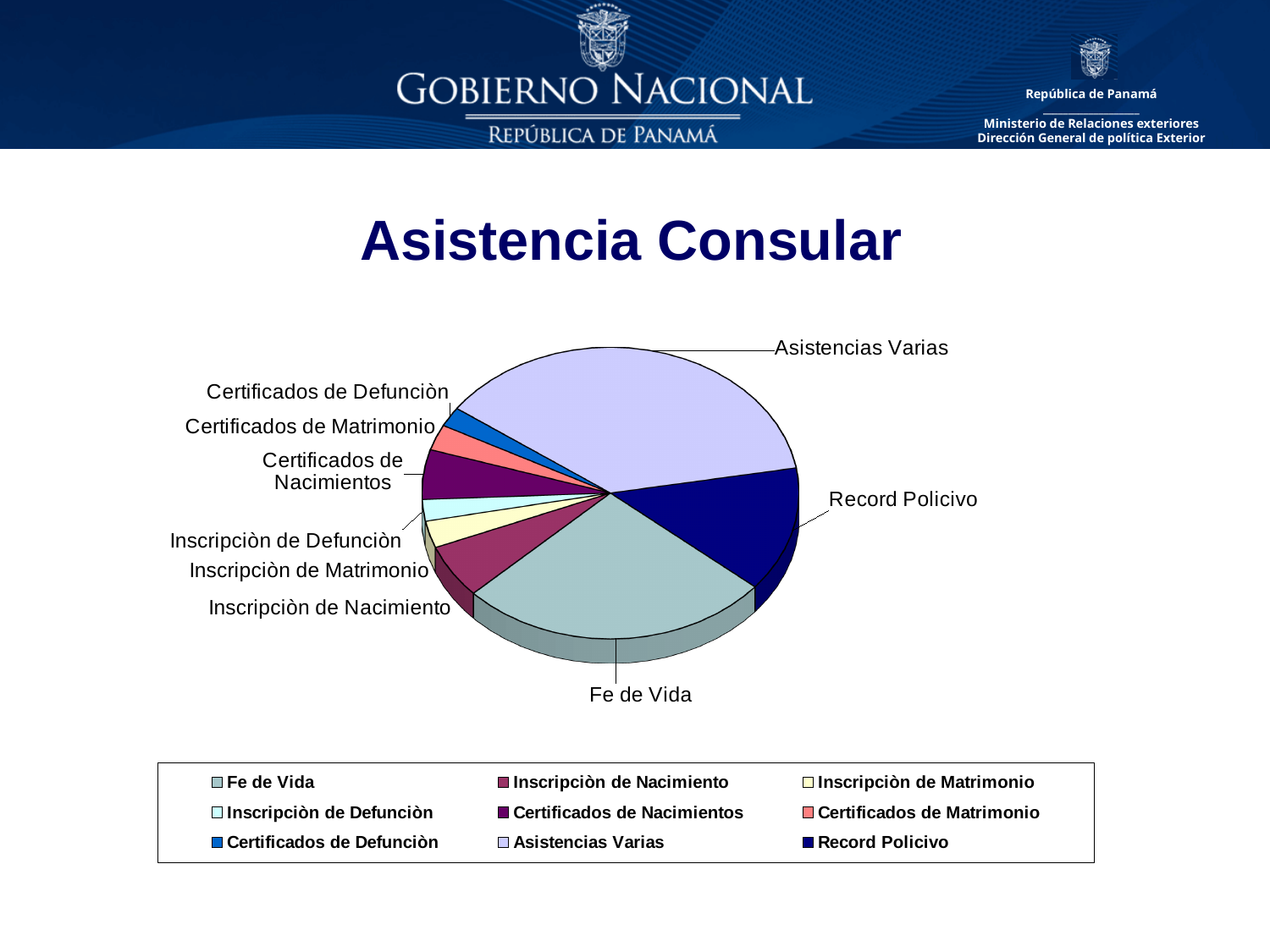
Which slice is larger, Fe de Vida or Inscripciòn de Nacimiento? Fe de Vida How many entries does the chart legend list? 9 Which category has the largest slice of the pie? Asistencias Varias What colour is the Record Policivo slice in the pie chart? Dark navy blue How many categories (slices) does the pie chart have? 9 Which category is the second-largest slice of the pie? Fe de Vida Which slice is larger, Fe de Vida or Record Policivo? Fe de Vida What kind of chart is shown on the slide? Pie chart What is the title of the chart on the slide? Asistencia Consular Which slice is larger, Record Policivo or Certificados de Matrimonio? Record Policivo